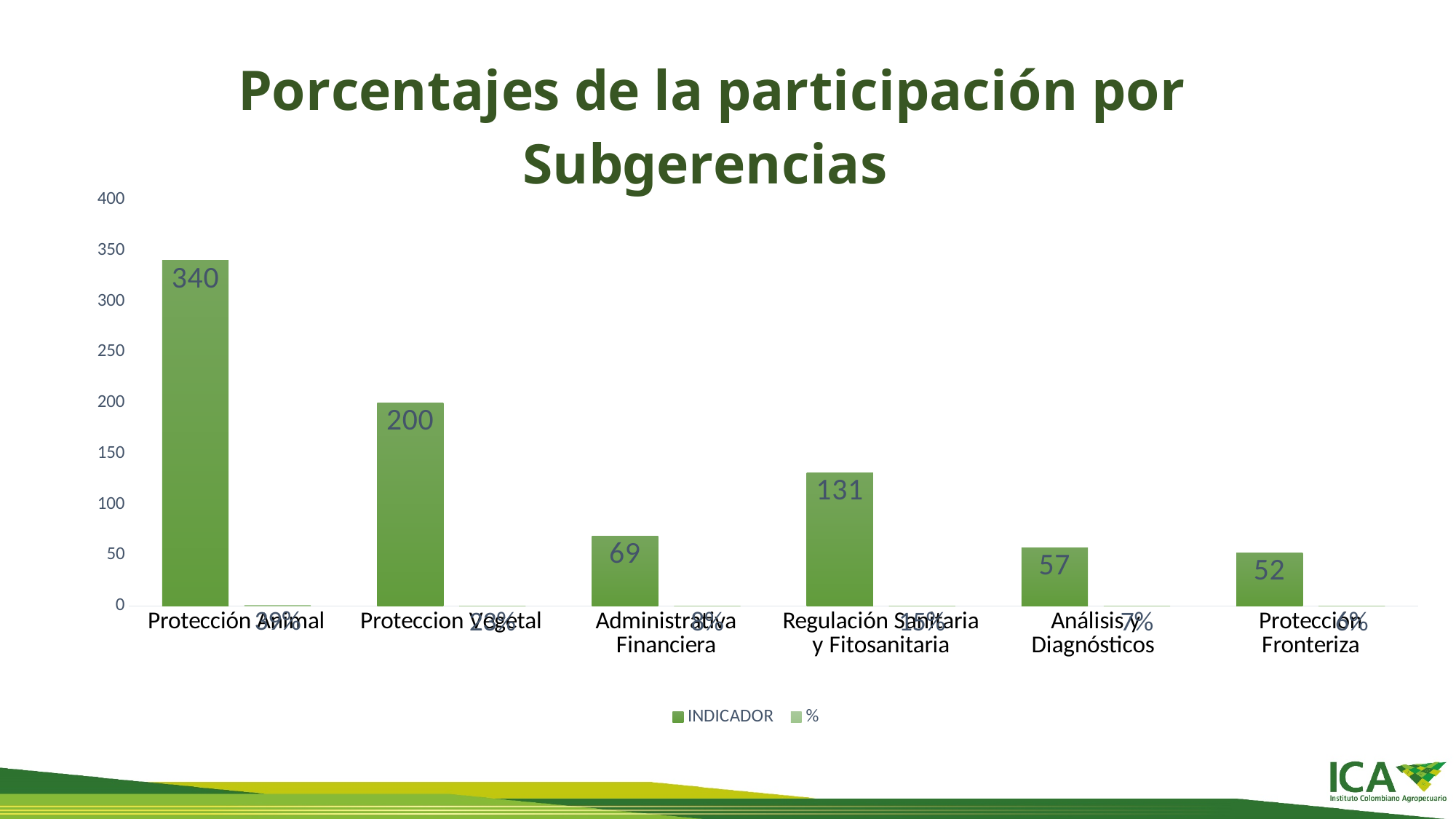
What is the difference between the INDICADOR values for Protección Animal and Proteccion Vegetal? 140 What is the INDICADOR value for Administrativa Financiera? 69 Which category has the highest INDICADOR value? Protección Animal Which has a larger INDICADOR value, Análisis y Diagnósticos or Administrativa Financiera? Administrativa Financiera What is the INDICADOR value for Protección Animal? 340 How many series does the legend list? 2 Which category has the lowest INDICADOR value? Protección Fronteriza What type of chart is shown on the slide? Bar chart What is the INDICADOR value for Regulación Sanitaria y Fitosanitaria? 131 What is the INDICADOR value for Protección Fronteriza? 52 What is the INDICADOR value for Proteccion Vegetal? 200 How many categories are shown on the x axis? 6